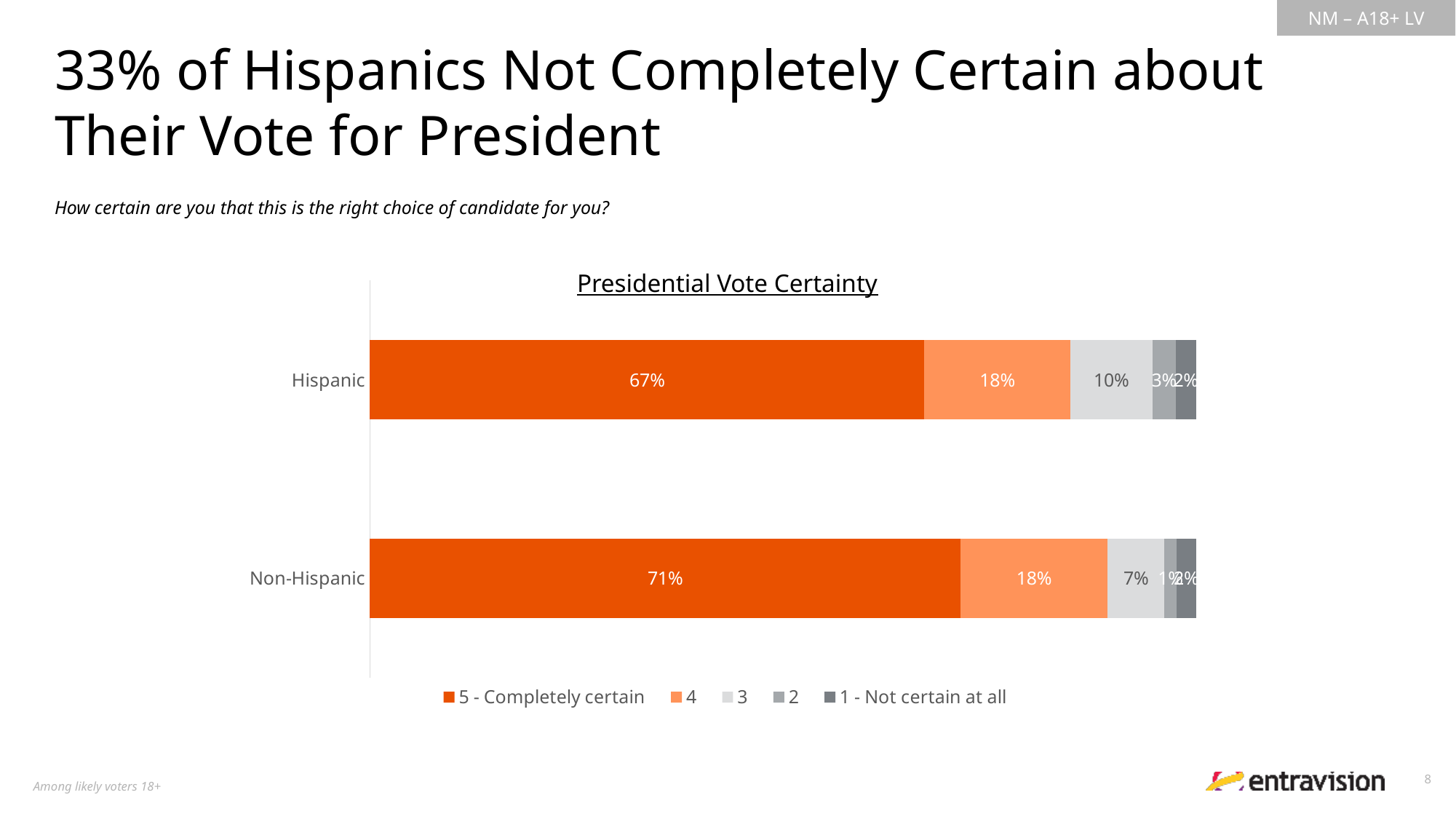
What percentage of Hispanic likely voters are '5 - Completely certain' about their presidential vote? 67% What is the value of the '3' segment for the Hispanic bar? 10% What is the value of the '4' segment for the Hispanic bar? 18% How many groups (bars) are shown in the chart? 2 What percentage of Non-Hispanic likely voters are '5 - Completely certain' about their presidential vote? 71% What is the value of the '3' segment for the Non-Hispanic bar? 7% How many series does the legend list? 5 What is the difference between the Hispanic and Non-Hispanic '3' segment values? 3 percentage points What is the title of the chart? Presidential Vote Certainty What is the difference between the Non-Hispanic and Hispanic '5 - Completely certain' values? 4 percentage points What type of chart is shown on the slide? Stacked bar chart Which group has the larger '5 - Completely certain' share, Hispanic or Non-Hispanic? Non-Hispanic